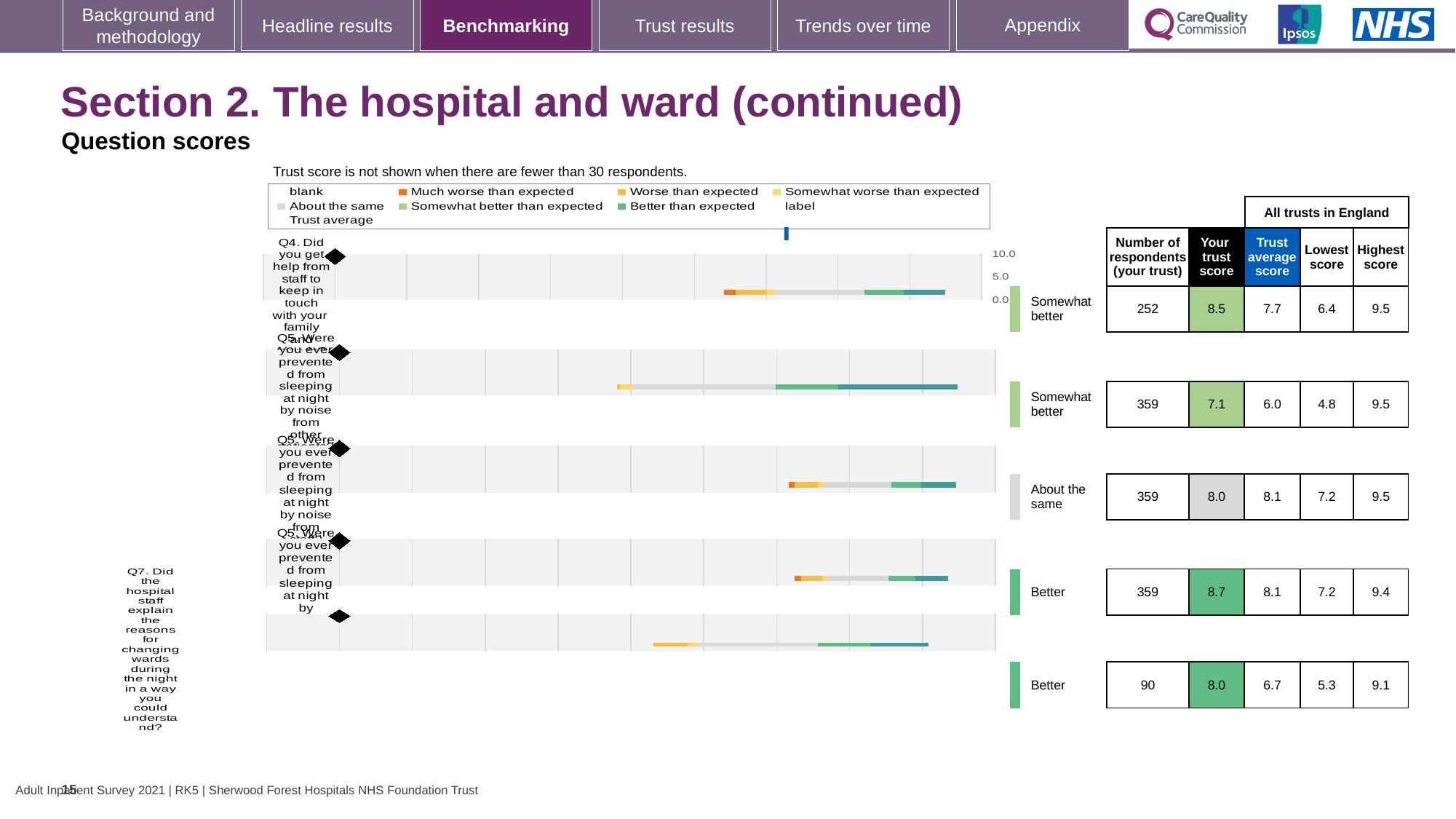
What is the benchmark category label shown for the fourth row of the table? Better Which row of the table has the highest 'Your trust score'? the fourth row (8.7) What kind of chart is used to show the question scores on this slide? bar chart How many question rows are plotted in the benchmarking chart? 5 What is the difference between the highest 'Your trust score' (8.7) and the lowest (7.1) in the table? 1.6 What is the number of respondents in the second row of the table? 359 What is the trust average score in the fifth (last) row of the table? 6.7 Which is larger in the third row of the table: 'Your trust score' or 'Trust average score'? Trust average score (8.1) Which row of the table has the lowest 'Your trust score'? the second row (7.1) What is the 'Your trust score' value in the first row of the table? 8.5 What is the lowest number of respondents shown in the table? 90